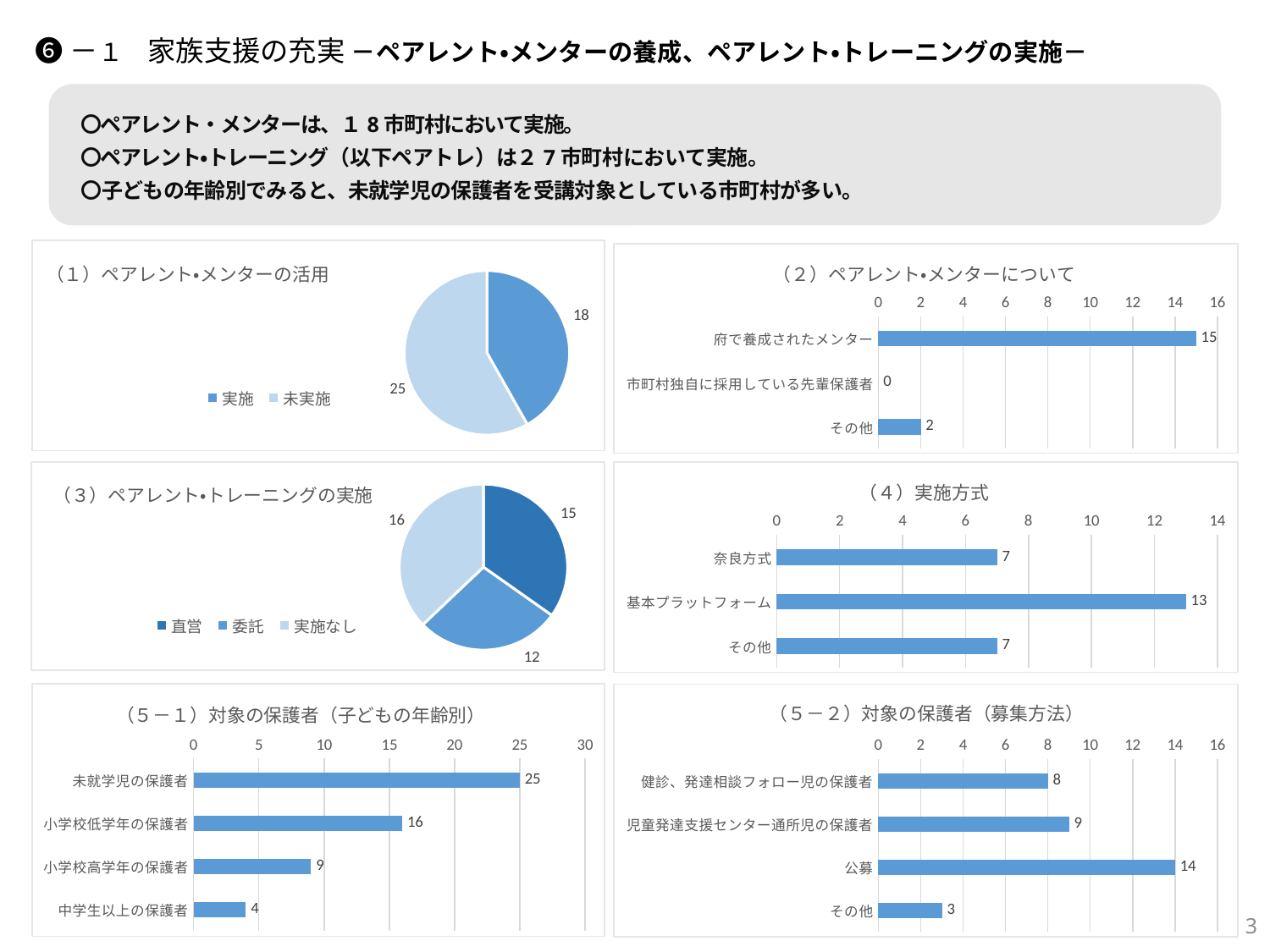
In chart (5－1) 対象の保護者（子どもの年齢別）, how many categories are shown? 4 In chart (5－1) 対象の保護者（子どもの年齢別）, what is the difference between 未就学児の保護者 and 中学生以上の保護者? 21 In chart (5－2) 対象の保護者（募集方法）, which is larger, 健診、発達相談フォロー児の保護者 or 公募? 公募 In chart (3) ペアレント・トレーニングの実施, what is the difference between 実施なし and 委託? 4 In chart (1) ペアレント・メンターの活用, what is the value for 実施? 18 In chart (2) ペアレント・メンターについて, what is the value for 府で養成されたメンター? 15 In chart (4) 実施方式, which category has the highest value? 基本プラットフォーム In chart (1) ペアレント・メンターの活用, what type of chart is shown? pie chart In chart (5－2) 対象の保護者（募集方法）, what is the value for その他? 3 In chart (3) ペアレント・トレーニングの実施, how many entries does the legend list? 3 In chart (4) 実施方式, what is the value for 奈良方式? 7 In chart (2) ペアレント・メンターについて, which category has the lowest value? 市町村独自に採用している先輩保護者